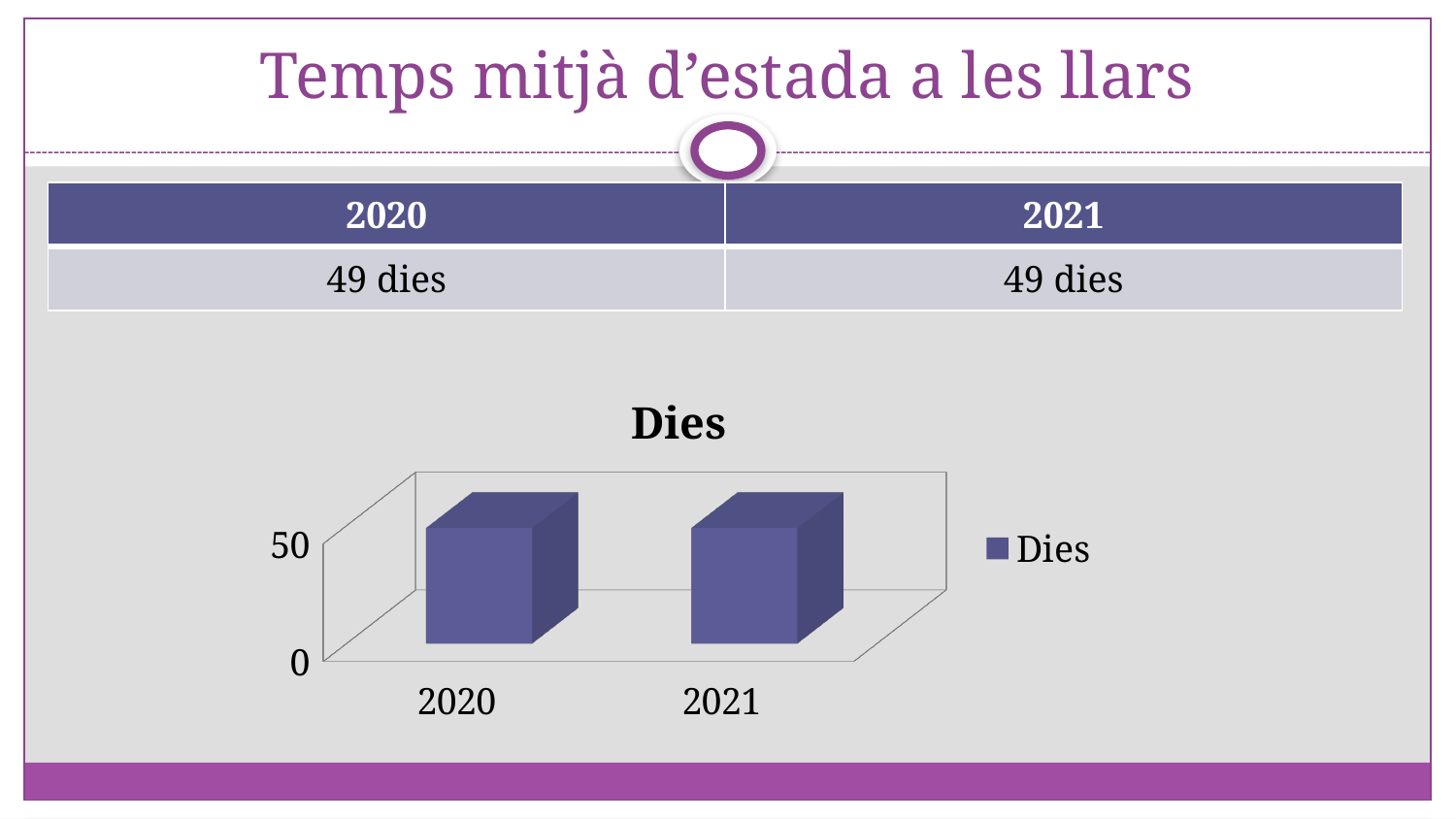
Do the values rise, fall or stay the same from 2020 to 2021? stay the same What is the value for 2020 according to the slide? 49 dies What kind of chart is shown on the slide? bar chart What is the title of the chart? Dies What is the difference between the values for 2020 and 2021? 0 dies How many series does the chart legend list? 1 What entry appears in the chart legend? Dies What is the value for 2021 according to the slide? 49 dies How many bars does the chart show? 2